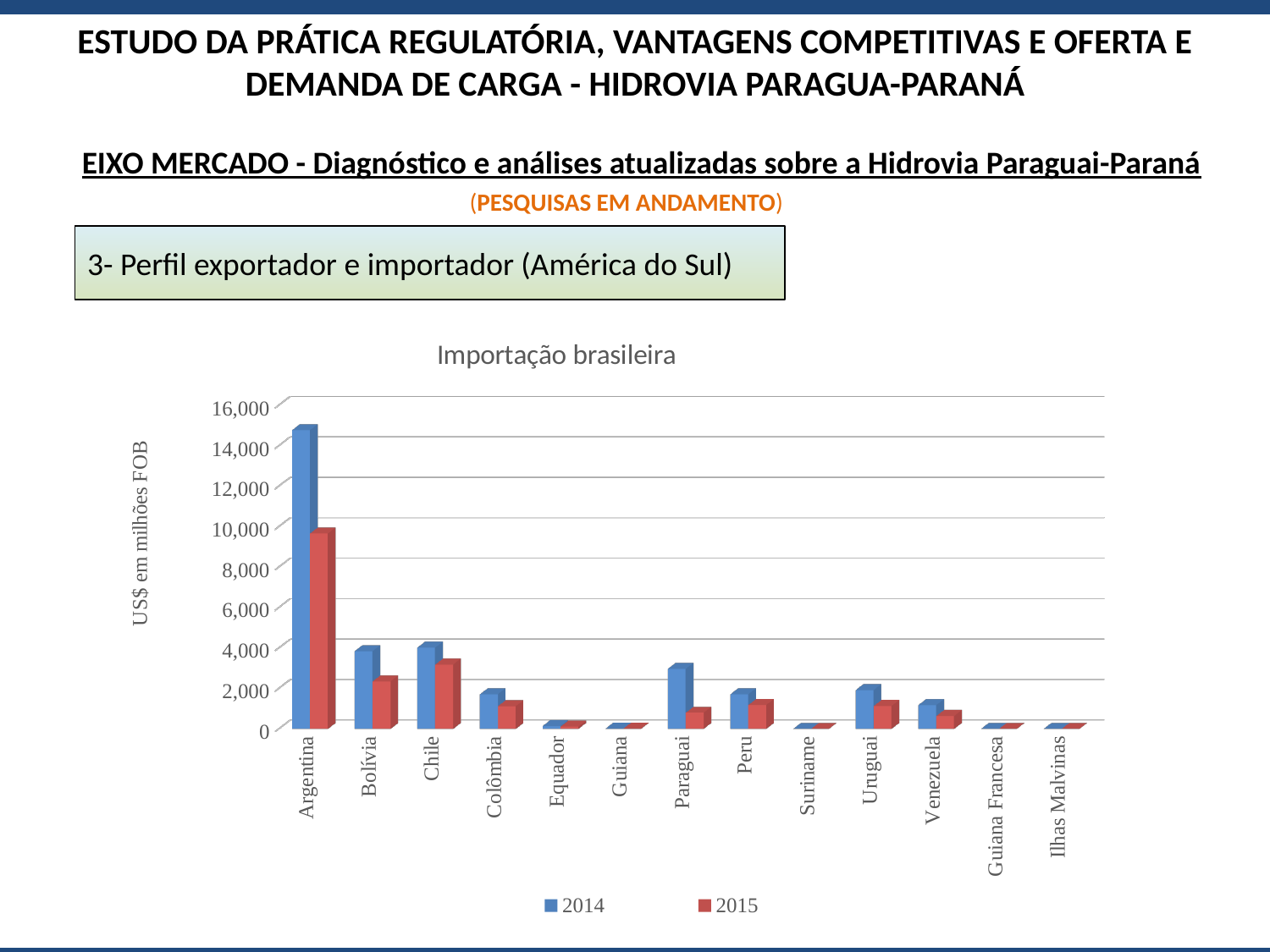
Which is larger: the 2014 value for Paraguai or the 2014 value for Uruguai? Paraguai Which country has the highest 2015 value in the "Importação brasileira" chart? Argentina What is the title of the chart on the slide? Importação brasileira Is the 2015 value for Paraguai greater or less than 2,000? less Is the 2015 value for Argentina greater or less than 8,000? greater How many countries are shown on the x axis of the "Importação brasileira" chart? 13 Is the 2014 value for Argentina greater or less than 12,000? greater Which country has the highest 2014 value in the "Importação brasileira" chart? Argentina What is the label of the vertical axis of the chart? US$ em milhões FOB What kind of chart is shown on the slide? bar chart For Argentina, which is larger: the 2014 value or the 2015 value? 2014 How many series does the legend of the "Importação brasileira" chart list? 2